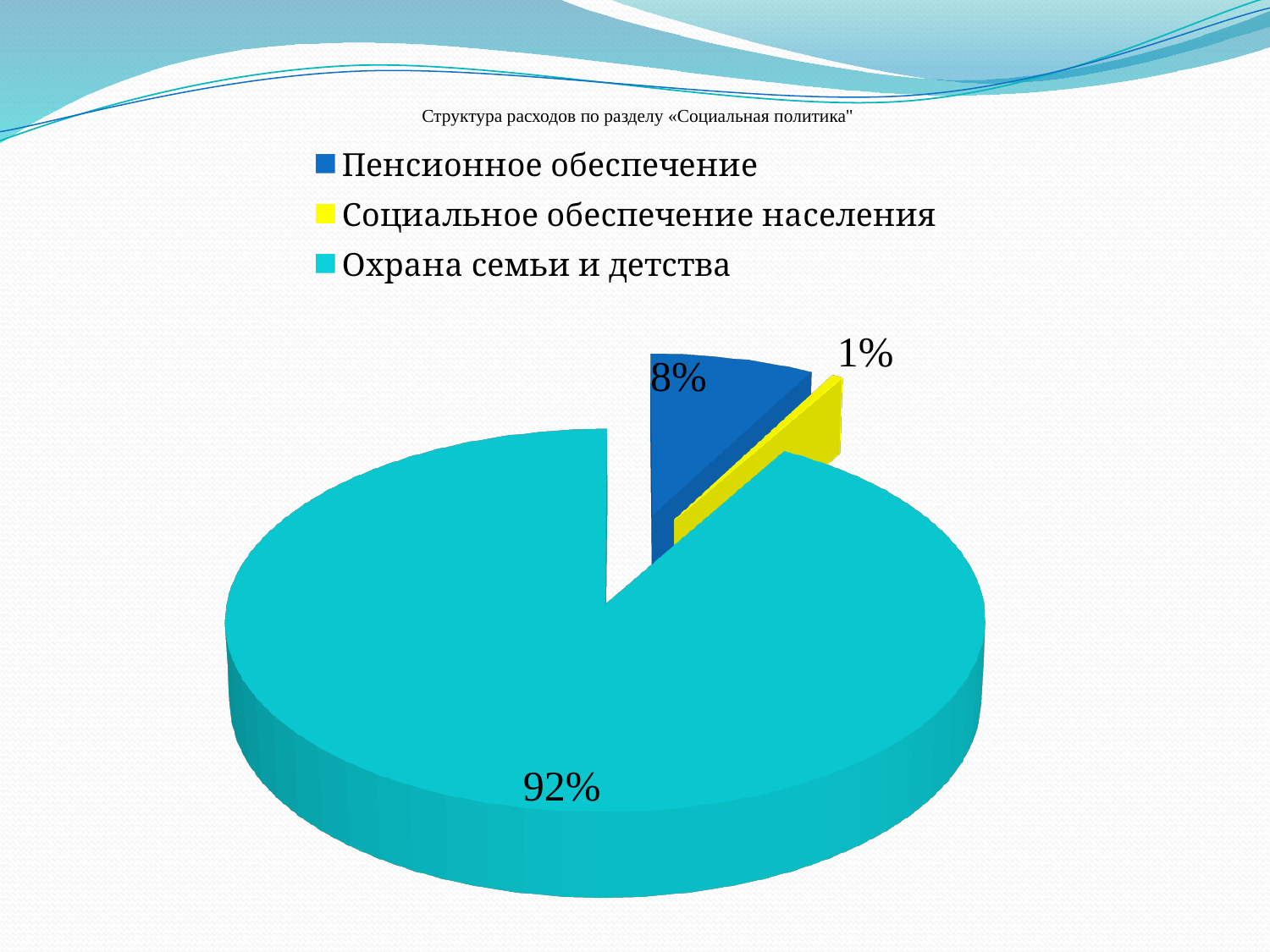
Which category has the largest slice of the pie? Охрана семьи и детства What share of the pie does Социальное обеспечение населения have? 1% What colour is the slice for Социальное обеспечение населения? Yellow What share of the pie does Охрана семьи и детства have? 92% What kind of chart is shown on the slide? Pie chart Which category has the smallest slice of the pie? Социальное обеспечение населения What is the difference between the shares of Пенсионное обеспечение and Социальное обеспечение населения? 7% What is the difference between the shares of Охрана семьи и детства and Пенсионное обеспечение? 84% What share of the pie does Пенсионное обеспечение have? 8% How many entries does the legend list? 3 Which is larger, the share of Пенсионное обеспечение or the share of Социальное обеспечение населения? Пенсионное обеспечение How many slices does the pie chart have? 3